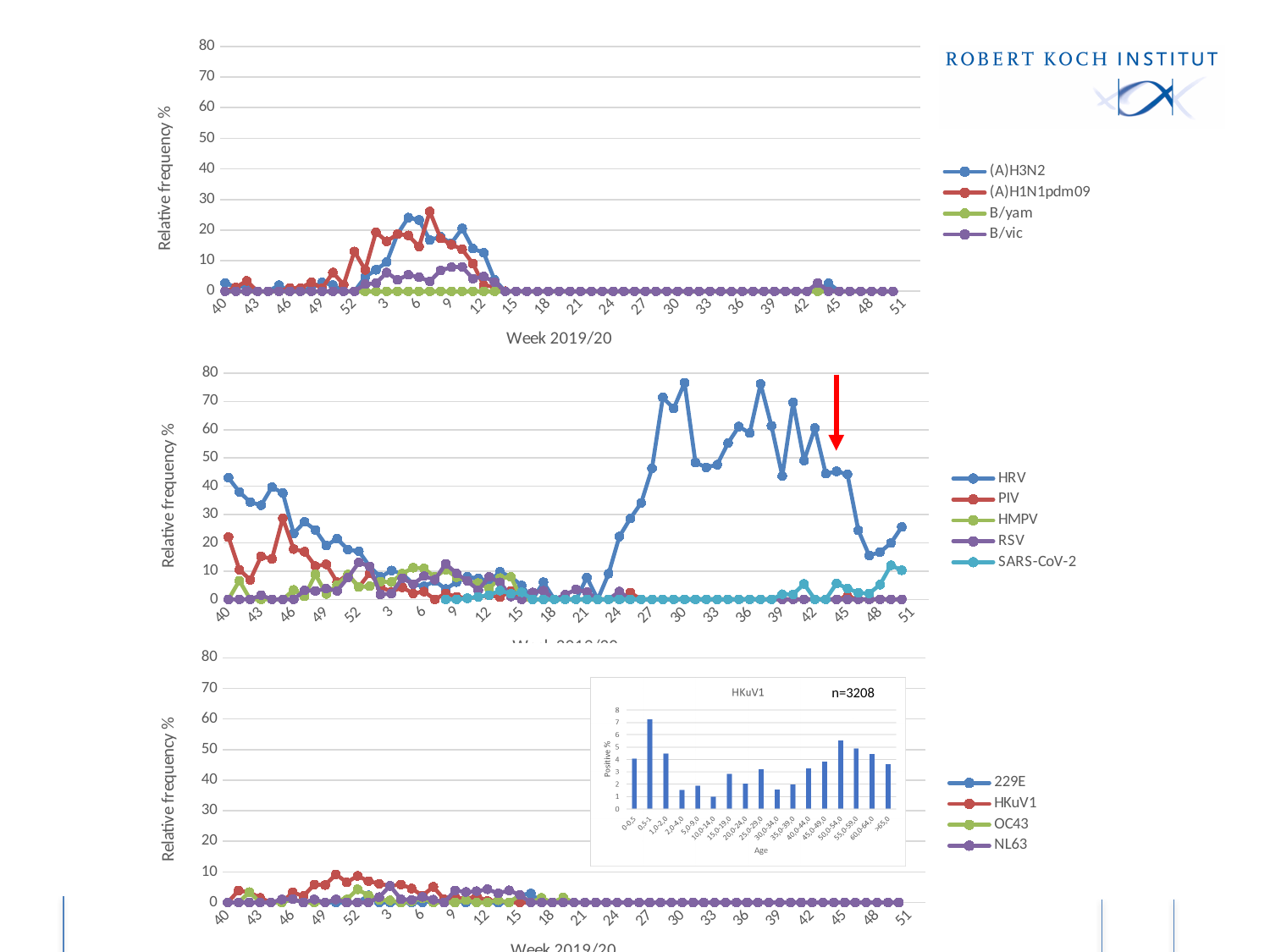
What sample size (n) is shown on the inset bar chart? n=3208 In the top chart, is the peak value of (A)H1N1pdm09 greater or less than 30? less What kind of chart is the top chart on the slide? line chart How many series does the legend of the middle chart list? 5 How many series does the legend of the bottom chart list? 4 In the inset bar chart, which age group has the highest Positive %? 0.5-1 In the middle chart, is the peak value of HRV around week 30 greater or less than 70? greater What is the title of the inset bar chart in the bottom chart? HKuV1 In the middle chart, which series reaches the highest relative frequency? HRV In the middle chart, at week 40 which is larger, the value for HRV or the value for PIV? HRV How many series does the legend of the top chart list? 4